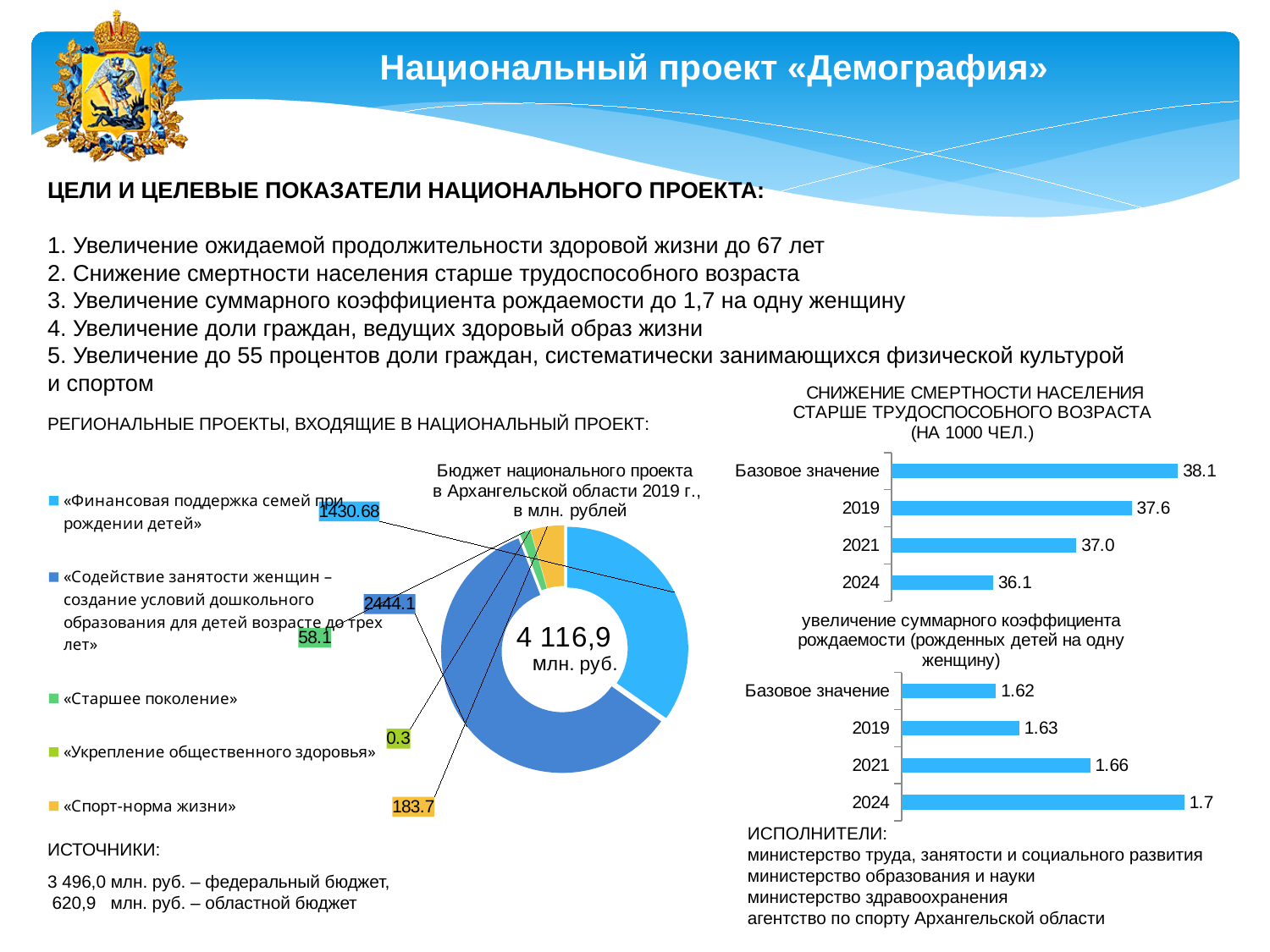
In the chart 'увеличение суммарного коэффициента рождаемости', which category has the highest value? 2024 In the chart 'Снижение смертности населения старше трудоспособного возраста', do the values rise or fall from 'Базовое значение' to 2024? fall In the chart 'Снижение смертности населения старше трудоспособного возраста', what is the difference between the 'Базовое значение' and the 2024 value? 2.0 In the chart 'Снижение смертности населения старше трудоспособного возраста', what is the value for 'Базовое значение'? 38.1 In the doughnut chart 'Бюджет национального проекта в Архангельской области 2019 г.', what is the value for 'Содействие занятости женщин – создание условий дошкольного образования для детей возрасте до трех лет'? 2444.1 In the chart 'увеличение суммарного коэффициента рождаемости', what is the value for 2021? 1.66 In the doughnut chart 'Бюджет национального проекта в Архангельской области 2019 г.', how many entries does the legend list? 5 In the doughnut chart 'Бюджет национального проекта в Архангельской области 2019 г.', what is the value for 'Спорт-норма жизни'? 183.7 In the chart 'Снижение смертности населения старше трудоспособного возраста', which category has the lowest value? 2024 In the chart 'Снижение смертности населения старше трудоспособного возраста', what is the value for 2019? 37.6 In the chart 'увеличение суммарного коэффициента рождаемости', how many categories are shown? 4 In the chart 'увеличение суммарного коэффициента рождаемости', what kind of chart is it? bar chart